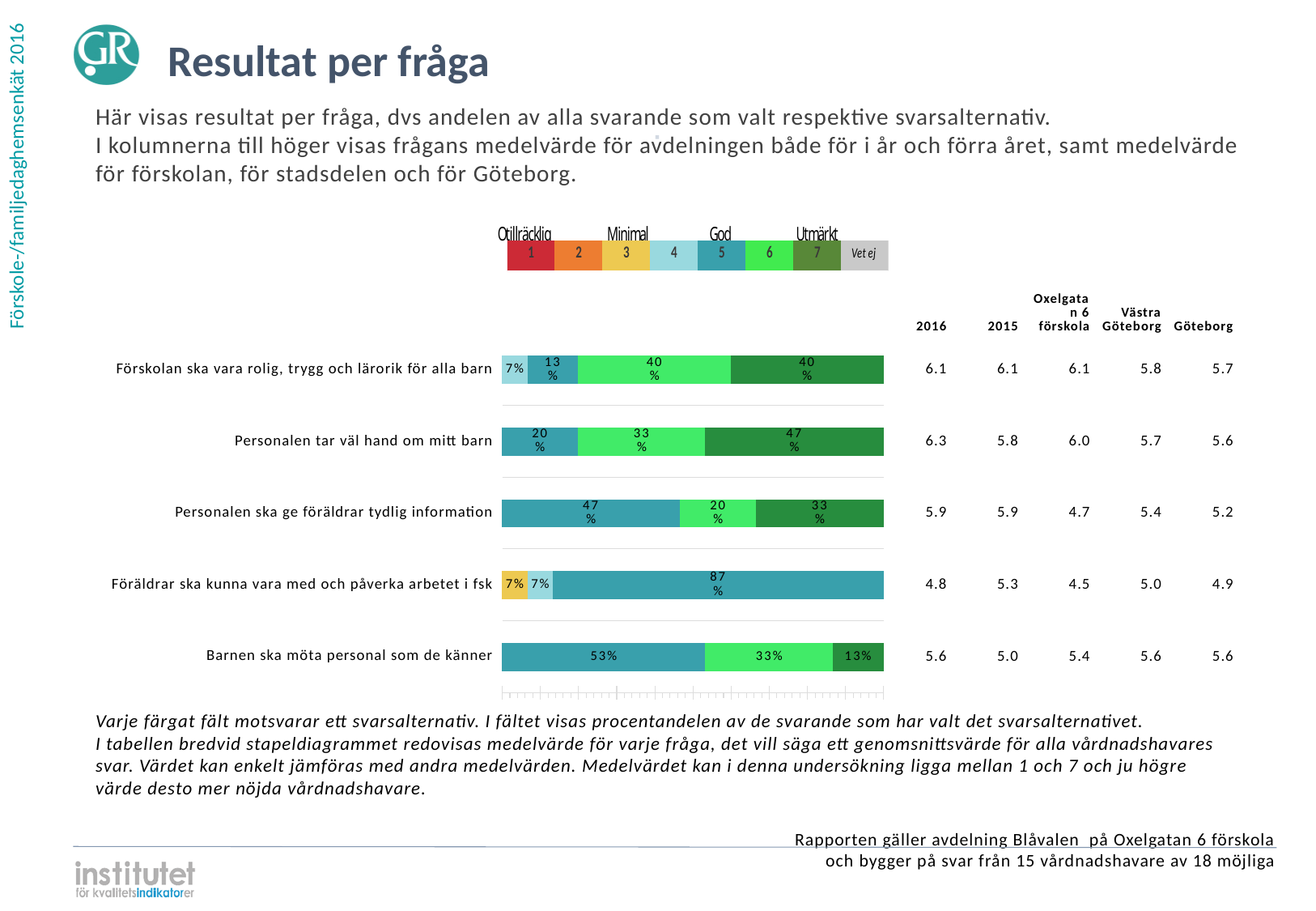
What is the largest segment value in the bar for 'Föräldrar ska kunna vara med och påverka arbetet i fsk'? 87% How many answer alternatives does the legend above the chart list? 8 What percentage of respondents chose alternative 7 for 'Personalen tar väl hand om mitt barn'? 47% For 'Personalen ska ge föräldrar tydlig information', which is larger: the alternative 5 segment or the alternative 7 segment? Alternative 5 (47%) What is the 2016 mean value shown for 'Personalen tar väl hand om mitt barn'? 6.3 What is the total of the labelled segments in the bar for 'Förskolan ska vara rolig, trygg och lärorik för alla barn'? 100% How many questions (categories) are plotted in the bar chart? 5 What kind of chart is shown on the slide? Stacked bar chart What percentage is shown for the first (teal, alternative 5) segment of 'Barnen ska möta personal som de känner'? 53% For 'Förskolan ska vara rolig, trygg och lärorik för alla barn', what is the difference in percentage points between the alternative 6 segment (40%) and the alternative 5 segment (13%)? 27 percentage points Which question has the largest share of respondents choosing alternative 7 (dark green)? Personalen tar väl hand om mitt barn What label does the legend give to answer alternative 7? Utmärkt